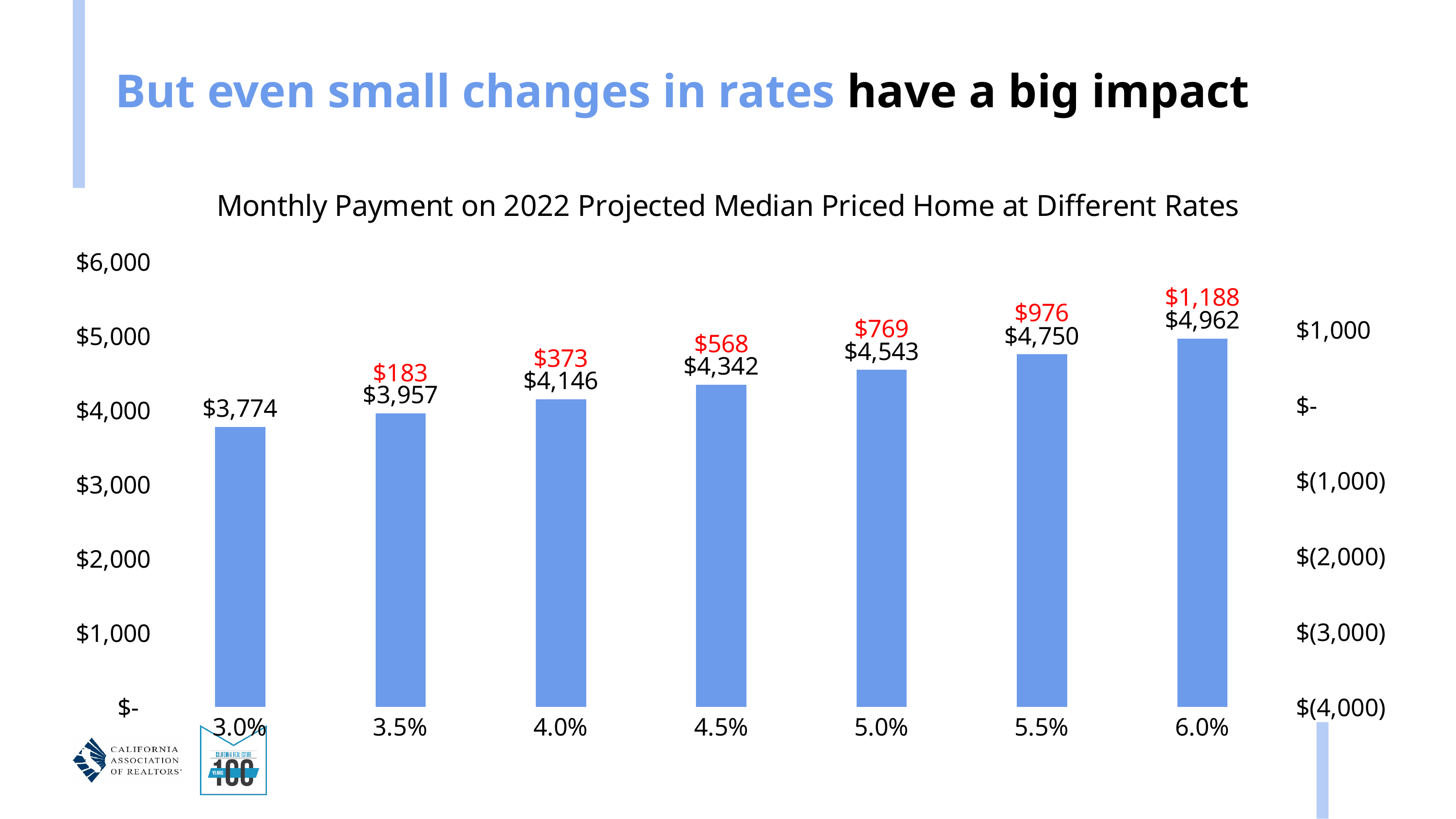
Do the monthly payments rise or fall as the rate increases along the x axis? Rise Which is larger, the monthly payment at 4.0% or at 5.5%? 5.5% How many rate categories are shown on the x axis? 7 What kind of chart is shown on the slide? Bar chart Which rate has the lowest monthly payment? 3.0% Which rate has the highest monthly payment? 6.0% What is the monthly payment at a 6.0% rate? $4,962 What is the difference between the monthly payment at 5.0% and at 4.0%? $397 What is the monthly payment at a 3.0% rate? $3,774 What is the difference between the monthly payment at 6.0% and at 3.0%? $1,188 What is the monthly payment at a 4.5% rate? $4,342 What is the red difference label shown above the 5.5% bar? $976